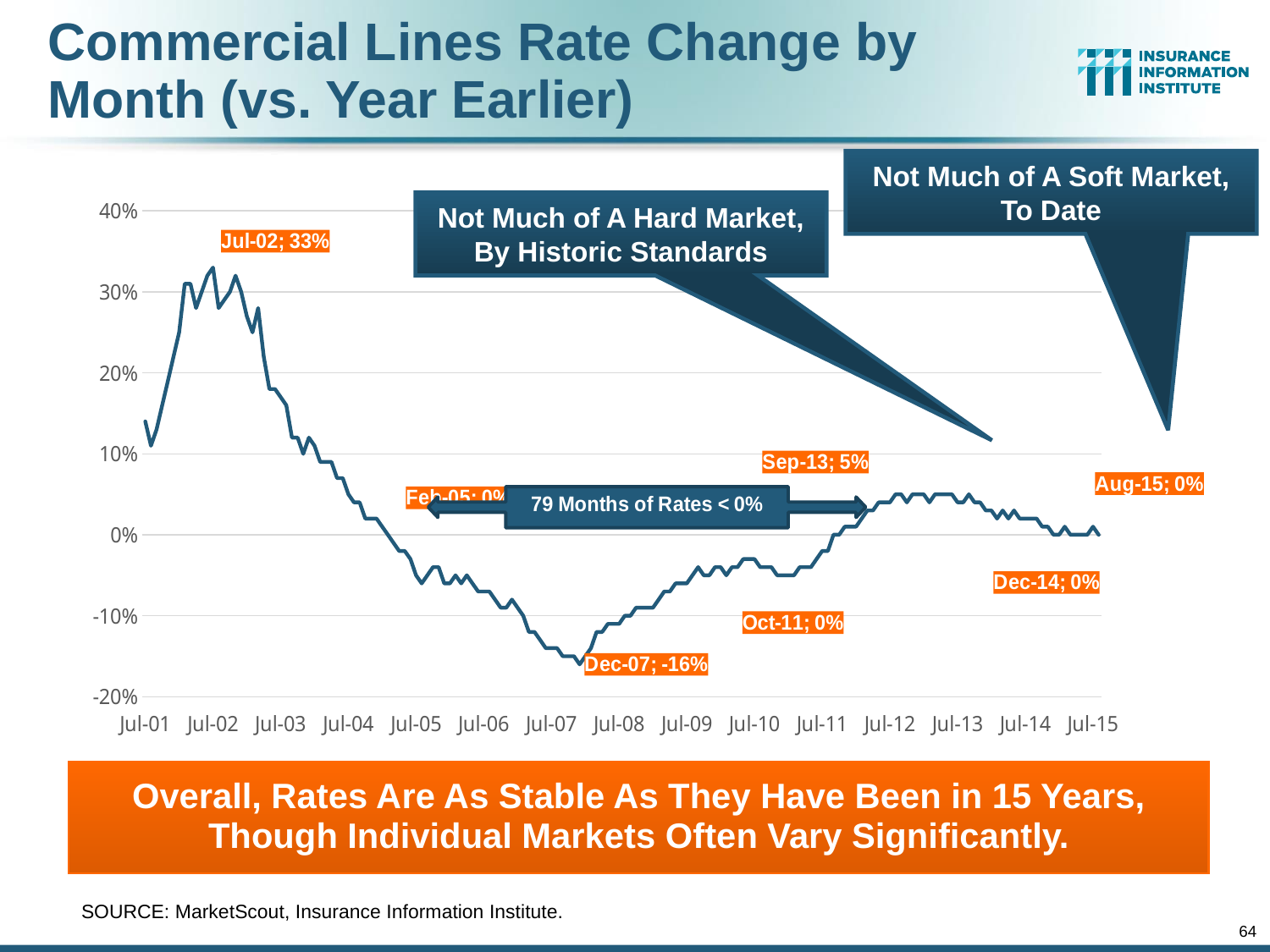
Which labeled point on the chart has the lowest value? Dec-07 Which labeled point on the chart has the highest value? Jul-02 What is the labeled value for Aug-15? 0% Is the value for Jul-09 greater or less than 0%? less According to the annotation on the chart, for how many months were rates below 0%? 79 months What is the labeled value for Dec-07? -16% What kind of chart is shown on the slide? Line chart What is the labeled value for Sep-13? 5% What is the difference between the labeled values for Jul-02 and Dec-07? 49 percentage points Which is larger, the labeled value for Sep-13 or for Aug-15? Sep-13 What is the labeled value for Oct-11? 0% What is the labeled value for Jul-02? 33%